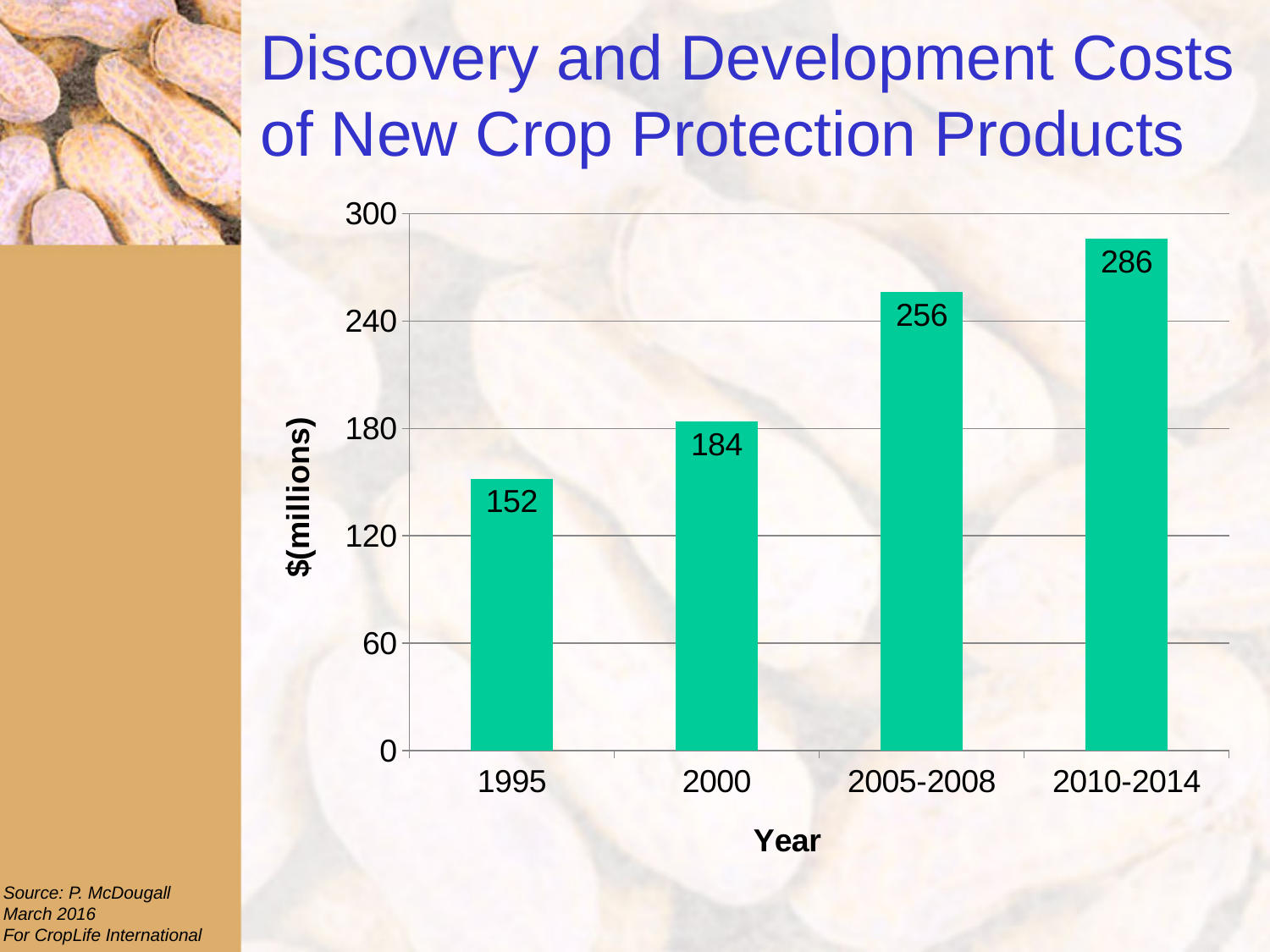
What kind of chart is shown on the slide? Bar chart Which period has the highest discovery and development cost? 2010-2014 What is the difference between the values for 2010-2014 and 1995? 134 What is the discovery and development cost for 1995? 152 What is the value shown for 2005-2008? 256 Which period has the lowest discovery and development cost? 1995 What is the value shown for 2010-2014? 286 Which is larger, the value for 2000 or the value for 2005-2008? 2005-2008 Do the values rise or fall from 1995 to 2010-2014? Rise How many periods are shown on the x axis? 4 What is the value shown for 2000? 184 What is the difference between the values for 2005-2008 and 2000? 72